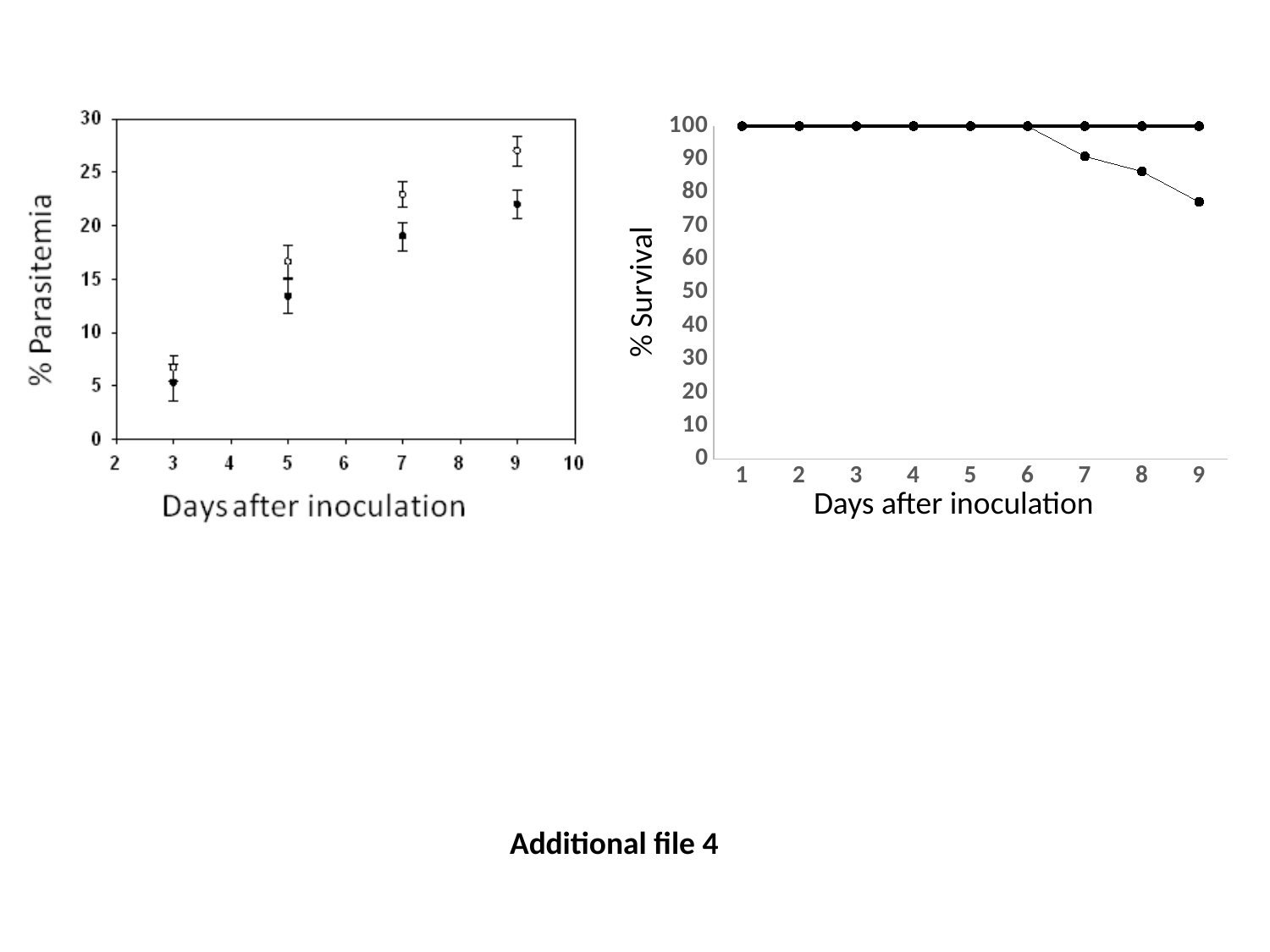
In the left-hand chart (% Parasitemia), is the open-circle value at day 9 greater or less than 25? greater In the right-hand chart (% Survival), how many days are shown on the x axis? 9 In the left-hand chart (% Parasitemia), at which day is parasitemia highest? 9 In the left-hand chart (% Parasitemia), do the values rise or fall as days after inoculation increase? rise What is the y-axis label of the right-hand chart? % Survival What kind of chart is the left-hand chart (% Parasitemia)? scatter chart In the right-hand chart (% Survival), what is the value of the thick line at day 9? 100 In the right-hand chart (% Survival), is the value of the thin line at day 9 greater or less than 80? less In the right-hand chart (% Survival), does the thin line rise or fall after day 6? fall What kind of chart is the right-hand chart (% Survival)? line chart In the left-hand chart (% Parasitemia), is the filled-circle value at day 3 greater or less than 10? less